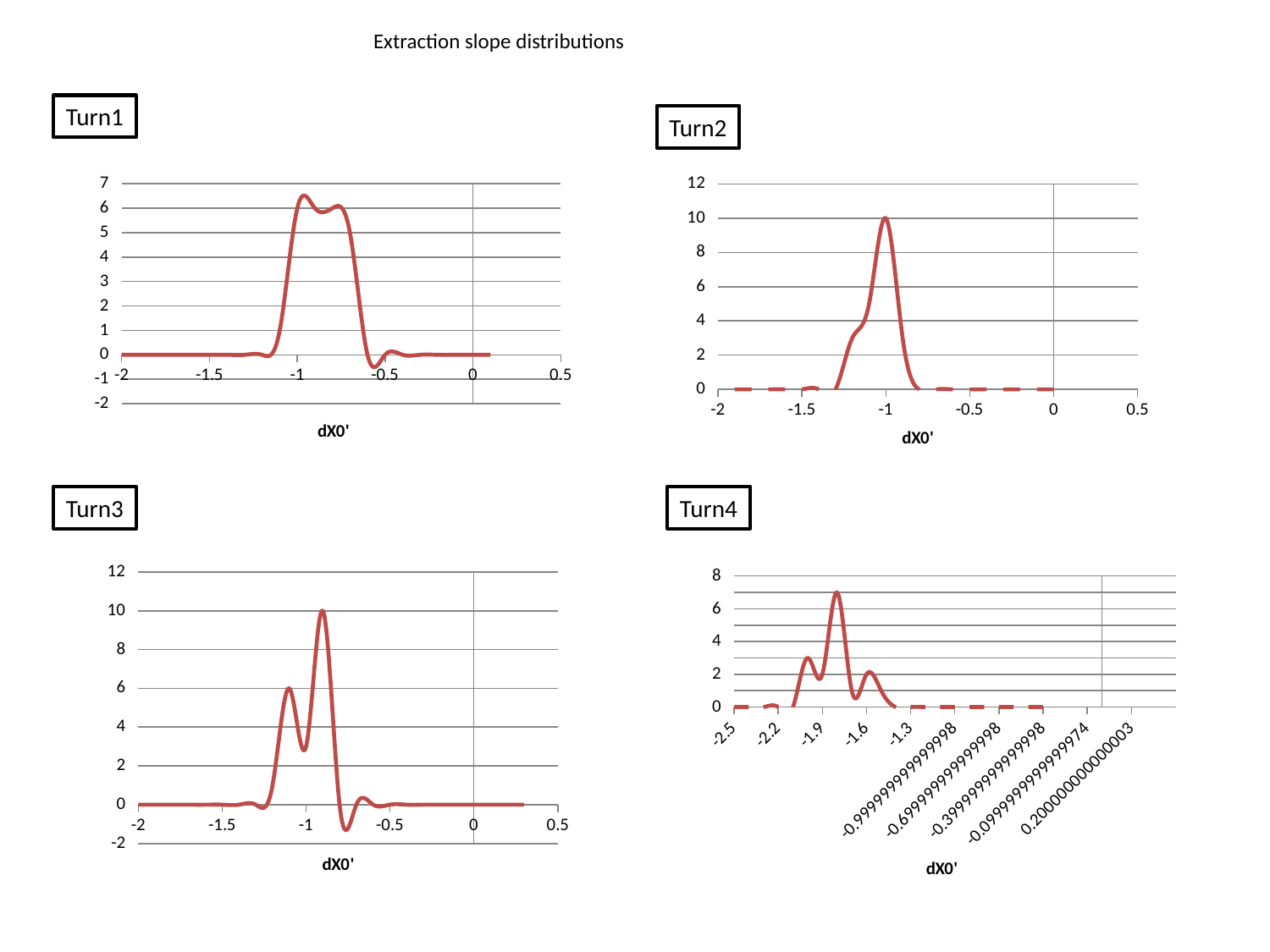
Which chart has the higher peak value, Turn3 or Turn4? Turn3 What is the title of the slide above the charts? Extraction slope distributions How many charts are shown on the slide? 4 What kind of chart is the Turn1 chart? line chart In the Turn4 chart, is the highest peak of the line greater or less than 6? greater What is the x-axis title of the Turn3 chart? dX0' In the Turn3 chart, is the highest peak of the line greater or less than 8? greater In the Turn3 chart, is the smaller peak near x = -1.1 greater or less than 8? less In the Turn2 chart, at which x-axis value does the line reach its peak? -1 In the Turn2 chart, what is the peak value of the line? 10 Which chart has the higher peak value, Turn1 or Turn2? Turn2